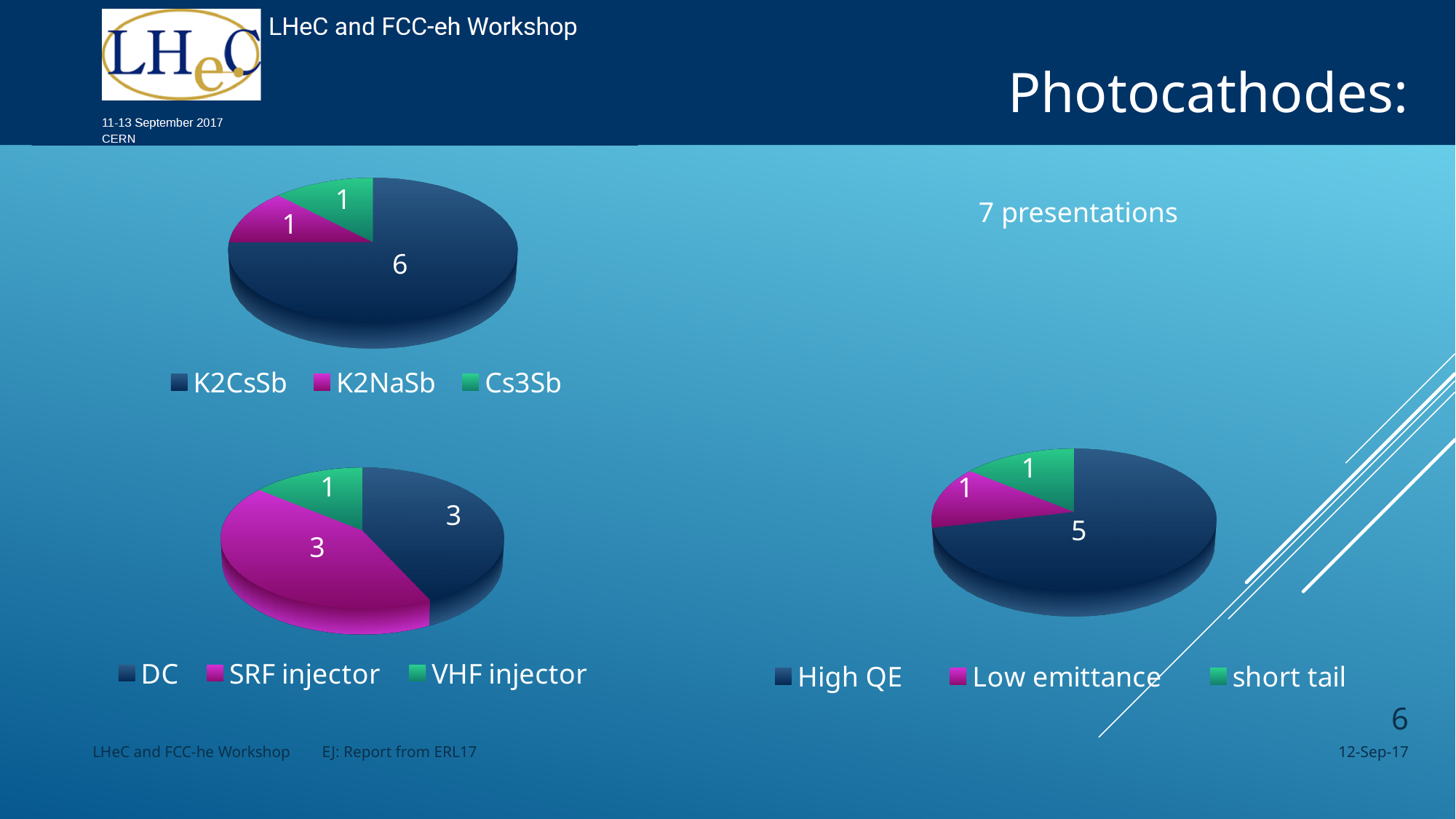
In the bottom-right pie chart, what is the difference between the values for High QE and short tail? 4 In the top-left pie chart, what is the difference between the values for K2CsSb and K2NaSb? 5 In the bottom-left pie chart, what is the total of all slices? 7 What type of chart is the top-left chart? pie chart In the bottom-left pie chart, which category has the smallest slice? VHF injector In the bottom-right pie chart, what is the value for High QE? 5 In the top-left pie chart, what is the value for K2CsSb? 6 How many categories does the legend of the bottom-right pie chart list? 3 In the top-left pie chart, what share of the total does K2CsSb represent? 75% In the bottom-left pie chart, is the value for DC larger or smaller than the value for VHF injector? larger In the top-left pie chart, which category has the largest slice? K2CsSb In the bottom-left pie chart, what is the value for SRF injector? 3